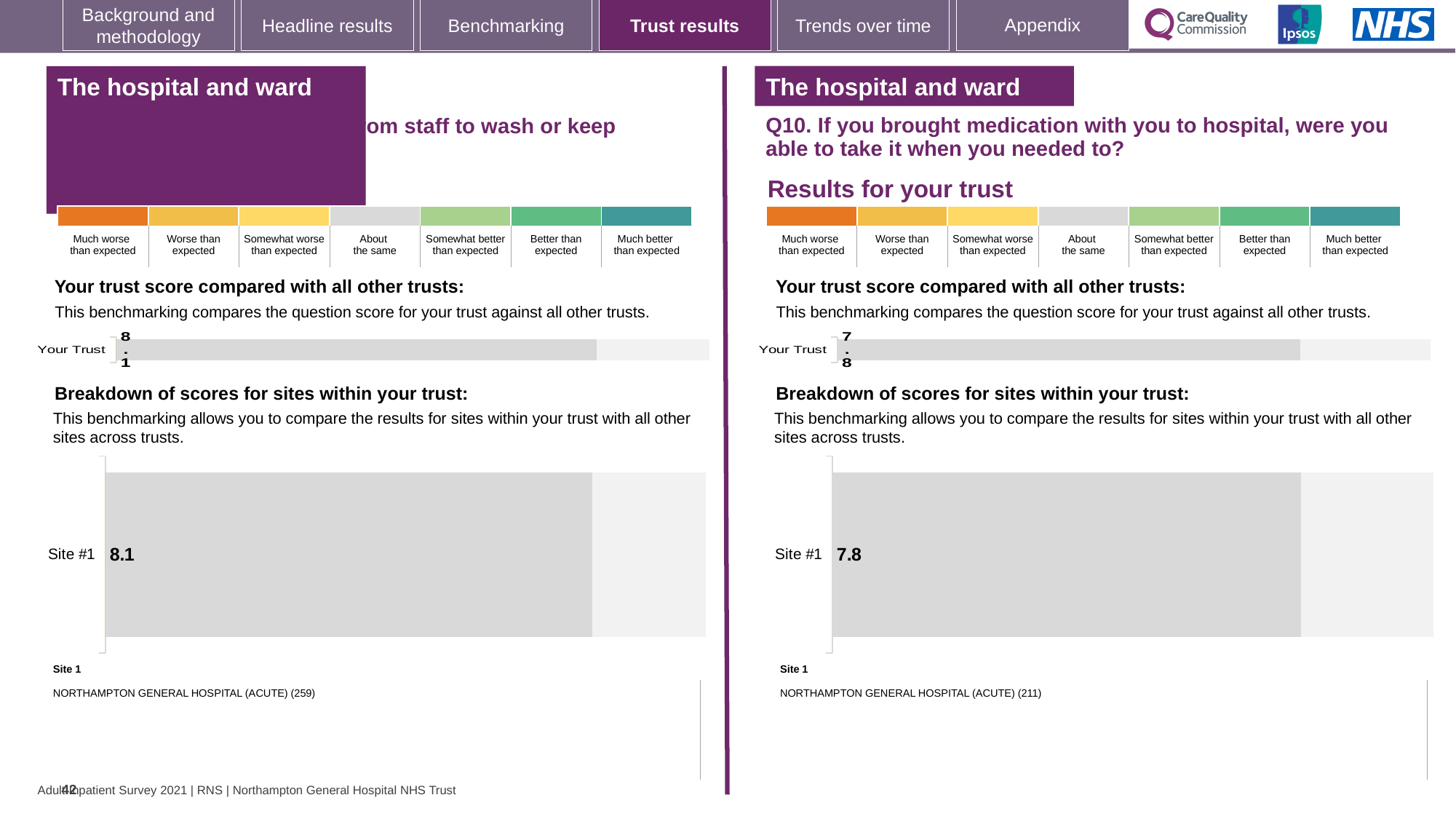
On the right-hand Q10 section, what number appears in parentheses after the Site 1 hospital name? 211 How many sites are shown in the right-hand Q10 breakdown of scores for sites within your trust? 1 On the right-hand chart for Q10 (medication brought to hospital), what is the score shown for Your Trust? 7.8 On the right-hand Q10 section, which hospital is listed as Site 1? NORTHAMPTON GENERAL HOSPITAL (ACUTE) What kind of chart is used to show the Your Trust score on the right-hand Q10 section? Bar chart How many sites are shown in the left-hand breakdown of scores for sites within your trust? 1 On the left-hand breakdown of scores for sites within your trust, what is the score for Site #1? 8.1 On the left-hand chart, what is the score shown for Your Trust? 8.1 On the right-hand Q10 breakdown of scores for sites within your trust, what is the score for Site #1? 7.8 Which is larger: the Your Trust score on the left-hand chart or the Your Trust score on the right-hand Q10 chart? The left-hand chart (8.1) What is the difference between the Site #1 score on the left-hand chart (8.1) and the Site #1 score on the right-hand Q10 chart (7.8)? 0.3